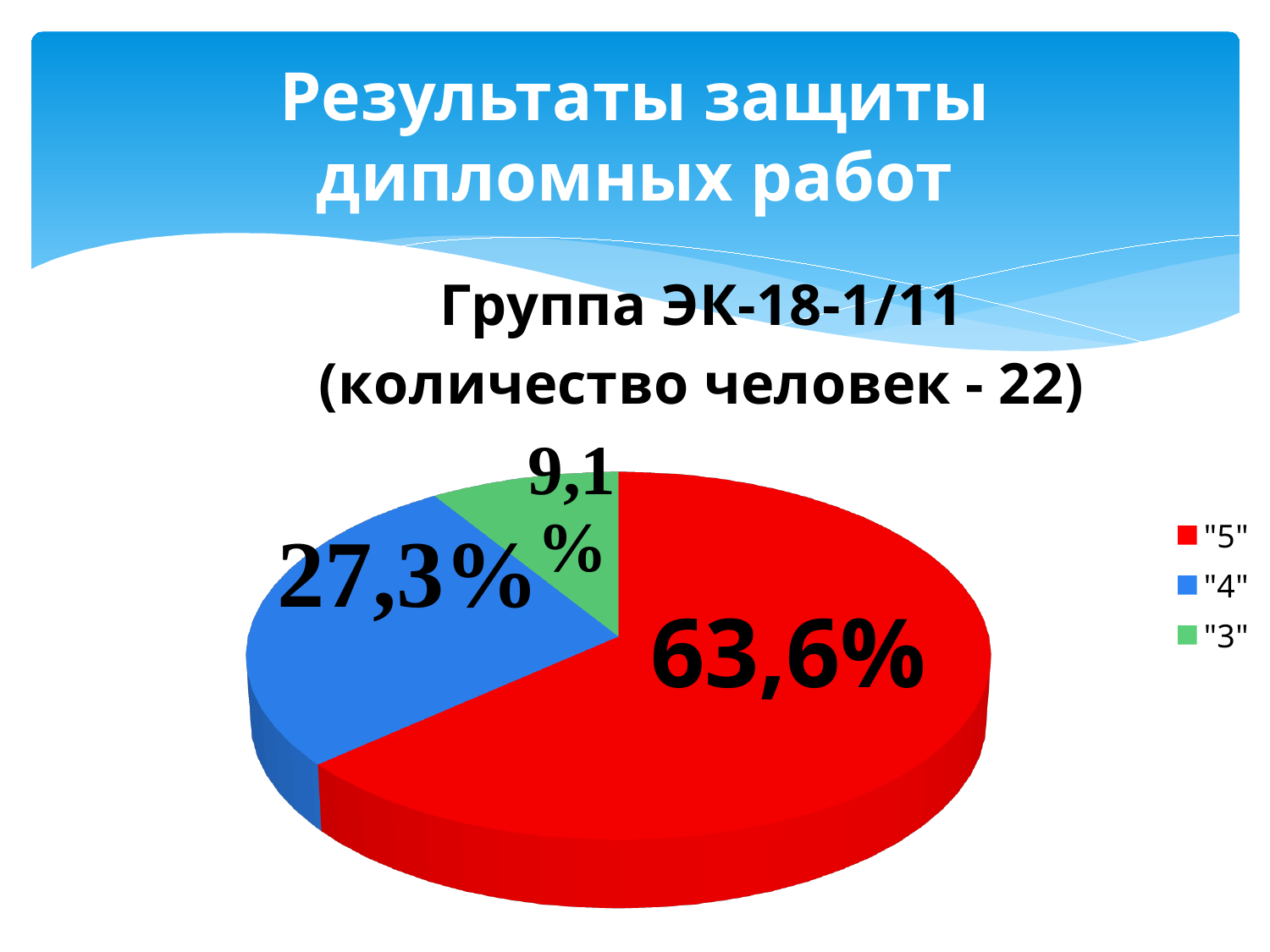
Which category has the smallest slice of the pie? "3" What is the difference in percentage points between the "5" slice and the "4" slice? 36,3 How many entries does the legend list? 3 What is the difference in percentage points between the "4" slice and the "3" slice? 18,2 What kind of chart is shown on the slide? Pie chart What share of the pie does the "4" slice represent? 27,3% What share of the pie does the "5" slice represent? 63,6% What share of the pie does the "3" slice represent? 9,1% What colour is the "5" slice in the pie chart? Red Which slice is larger, "4" or "3"? "4" How many slices does the pie chart have? 3 Which category has the largest slice of the pie? "5"